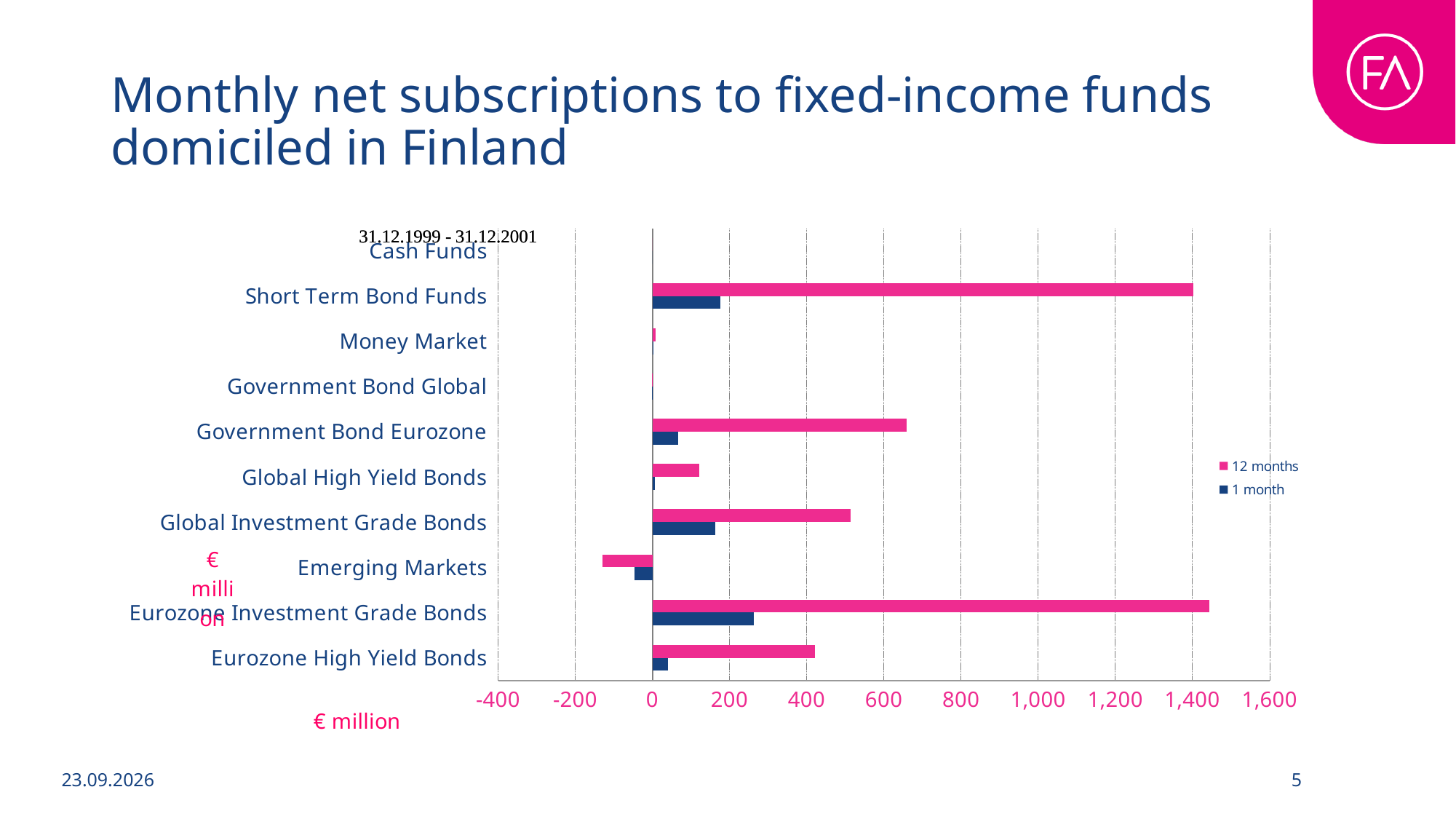
Which category has the highest 1 month value? Eurozone Investment Grade Bonds Which has the larger 12 months value, Government Bond Eurozone or Global Investment Grade Bonds? Government Bond Eurozone What unit is shown on the horizontal axis of the chart? € million Is the 12 months value for Short Term Bond Funds greater or less than 1,200? greater Which has the larger 1 month value, Short Term Bond Funds or Eurozone Investment Grade Bonds? Eurozone Investment Grade Bonds How many series does the legend list? 2 Is the 12 months value for Global Investment Grade Bonds greater or less than 400? greater What kind of chart is shown on the slide? bar chart How many fund categories are shown on the chart? 10 Is the 12 months value for Government Bond Eurozone greater or less than 800? less Which category has the lowest 12 months value? Emerging Markets